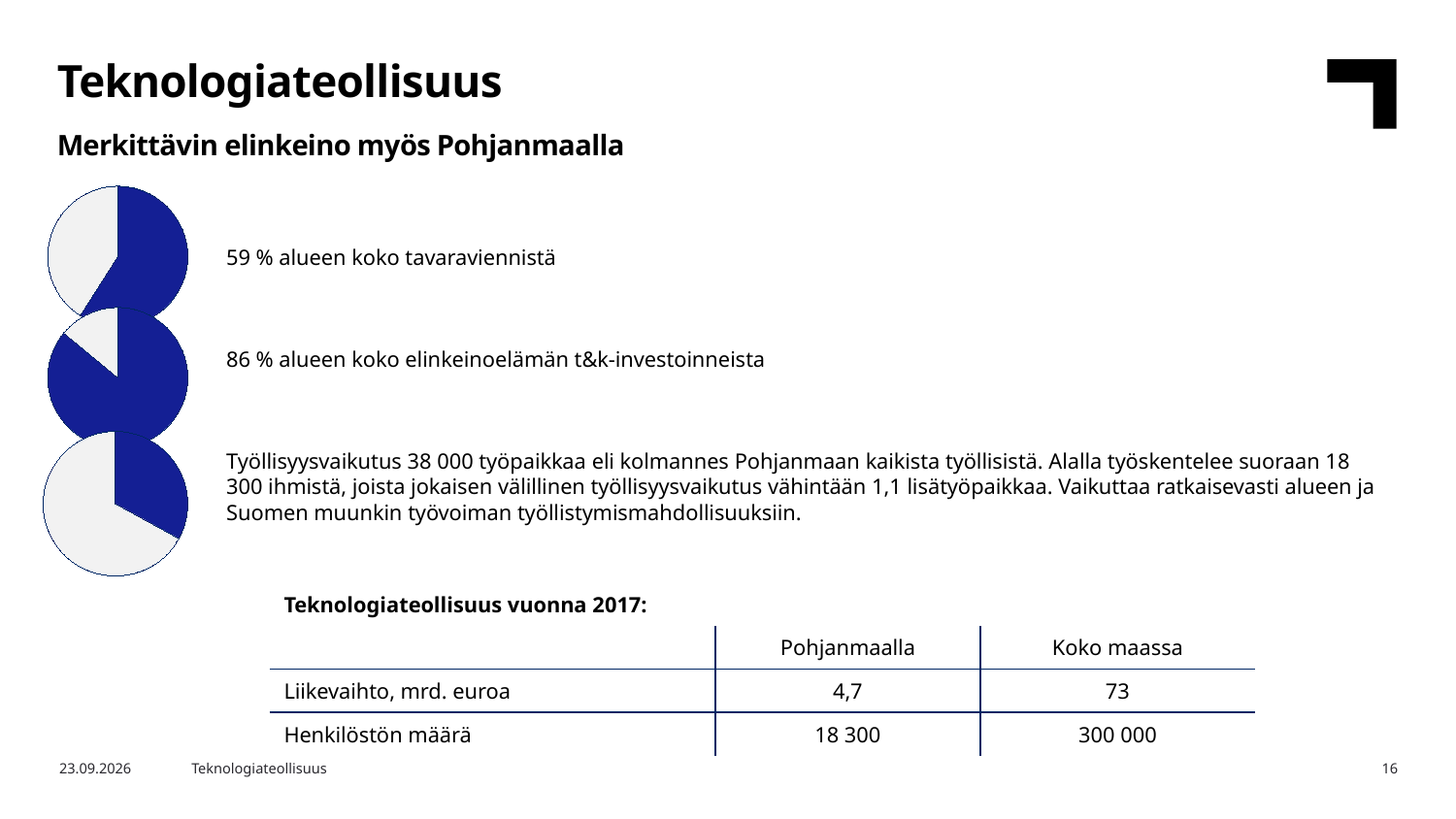
In the middle pie chart, what share of the region's business R&D investments does the blue slice represent, according to the text beside it? 86 % Which of the three pie charts has the largest blue slice? The middle pie chart (86 %) In the bottom pie chart, is the blue slice greater or less than 50% of the pie? less How many slices does each pie chart on the slide have? 2 What kind of charts are the three charts on the left side of the slide? Pie charts In the top pie chart, which slice is larger, the blue one or the grey one? The blue one What two colours are used for the slices in the pie charts? Blue and light grey Which of the three pie charts has the smallest blue slice? The bottom pie chart In the middle pie chart, is the blue slice greater or less than 75% of the pie? greater In the top pie chart, what share of the region's total goods exports does the blue slice represent, according to the text beside it? 59 % In the bottom pie chart, which slice is larger, the blue one or the grey one? The grey one How many pie charts are shown on the slide? 3